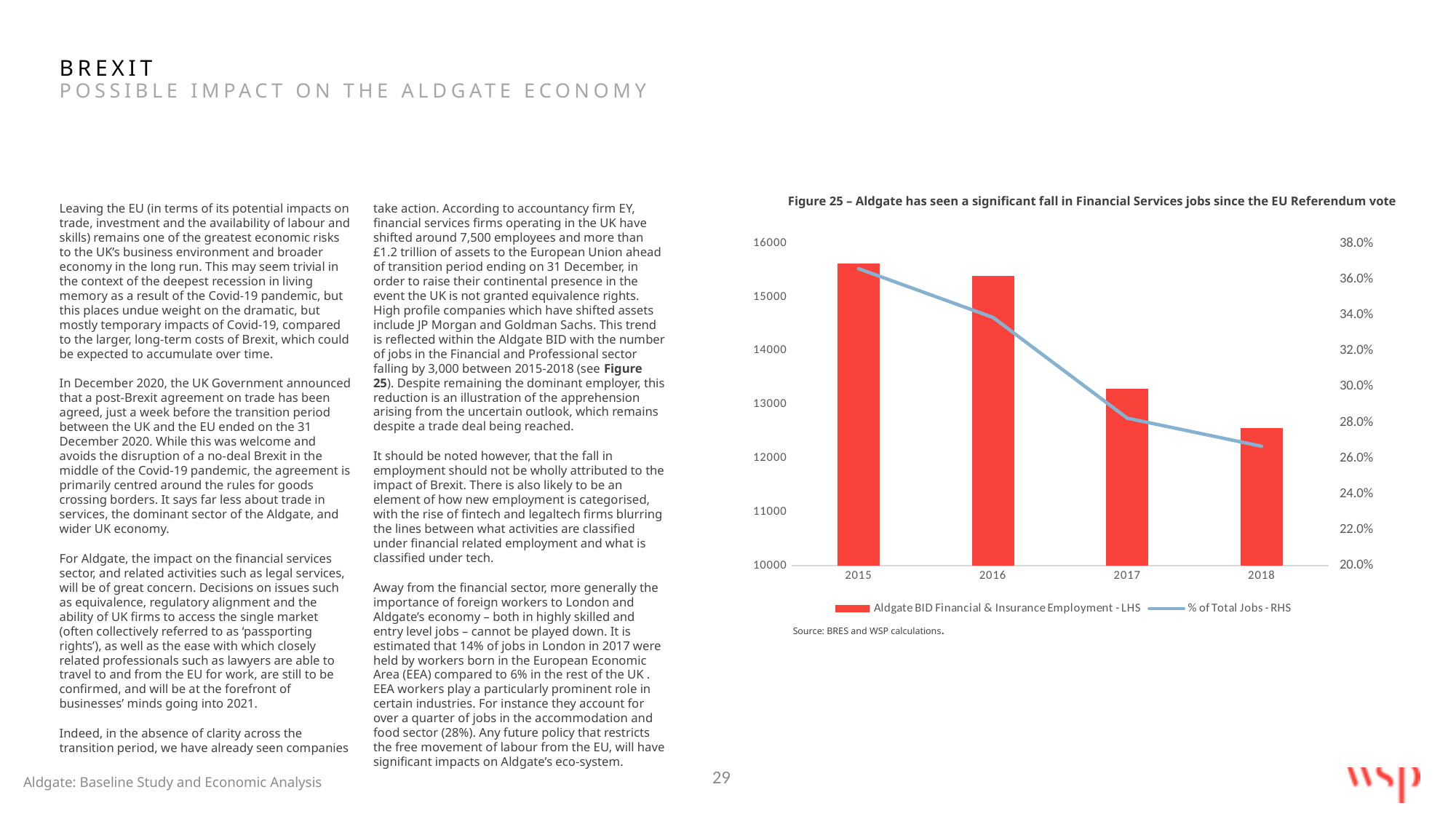
Is the % of Total Jobs value for 2015 greater or less than 34.0%? greater Does the % of Total Jobs line rise or fall from 2015 to 2018? Fall What kind of chart is shown in Figure 25? A combined bar and line chart How many series does the chart's legend list? 2 Which year has the larger Aldgate BID Financial & Insurance Employment bar, 2016 or 2017? 2016 What is the title of Figure 25? Aldgate has seen a significant fall in Financial Services jobs since the EU Referendum vote Is the Aldgate BID Financial & Insurance Employment value for 2018 greater or less than 13000? less Which year has the highest Aldgate BID Financial & Insurance Employment bar? 2015 Is the % of Total Jobs value for 2017 greater or less than 30.0%? less How many years are shown on the x axis of the chart? 4 Which year has the lowest Aldgate BID Financial & Insurance Employment bar? 2018